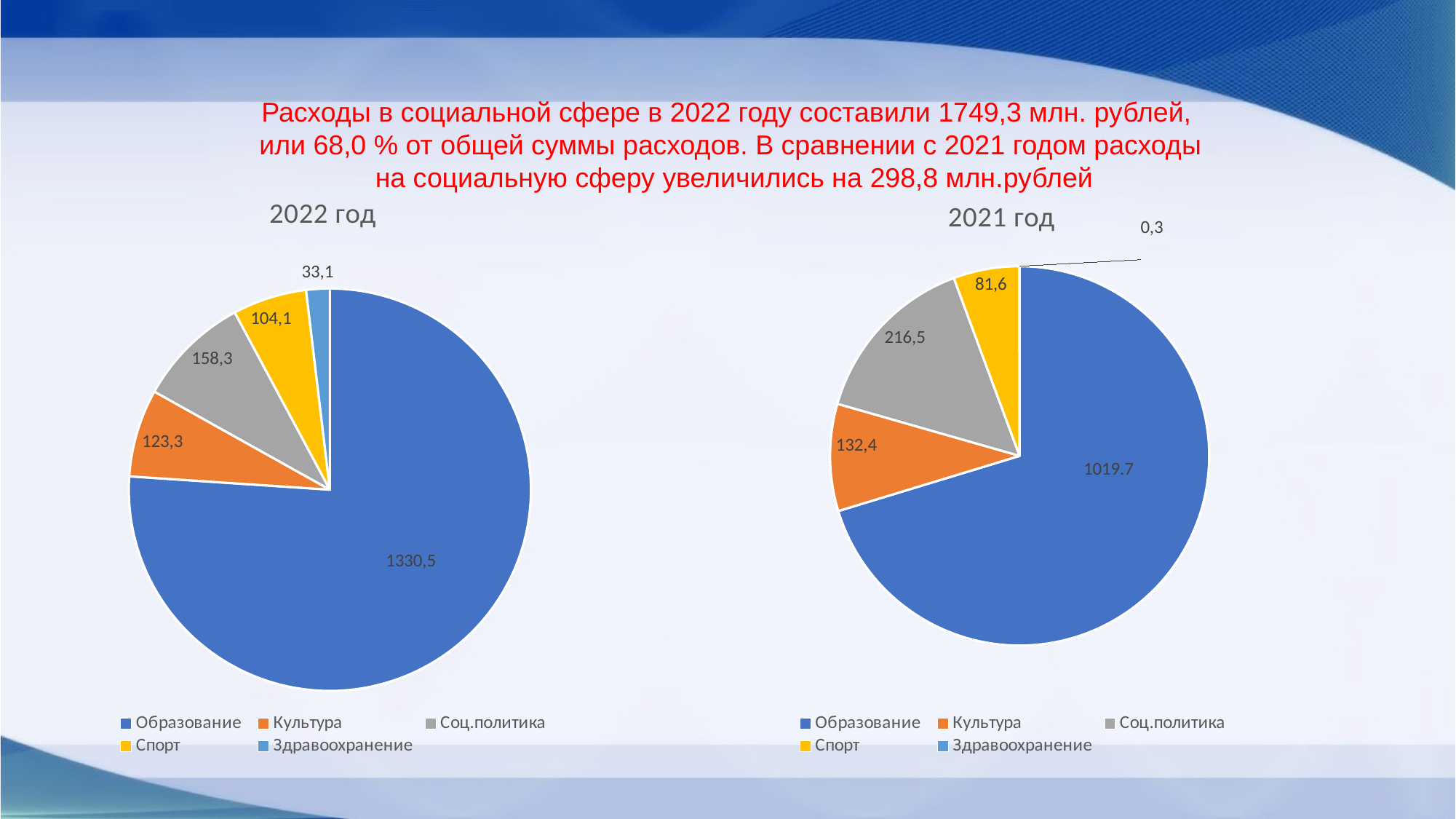
In the 2021 год pie chart, which is larger: Культура or Спорт? Культура In the 2022 год pie chart, which colour represents Спорт? Yellow In the 2021 год pie chart, which category has the smallest value? Здравоохранение In the 2021 год pie chart, what is the value for Соц.политика? 216,5 What type of chart is used for 2021 год? Pie chart In the 2022 год pie chart, what is the difference between Соц.политика and Культура? 35,0 In the 2021 год pie chart, what is the value for Спорт? 81,6 In the 2022 год pie chart, what is the value for Здравоохранение? 33,1 In the 2022 год pie chart, which category has the largest value? Образование What is the difference between the Образование value in the 2022 год chart and the Образование value in the 2021 год chart? 310,8 In the 2022 год pie chart, what is the value for Образование? 1330,5 How many categories does the 2022 год pie chart show? 5